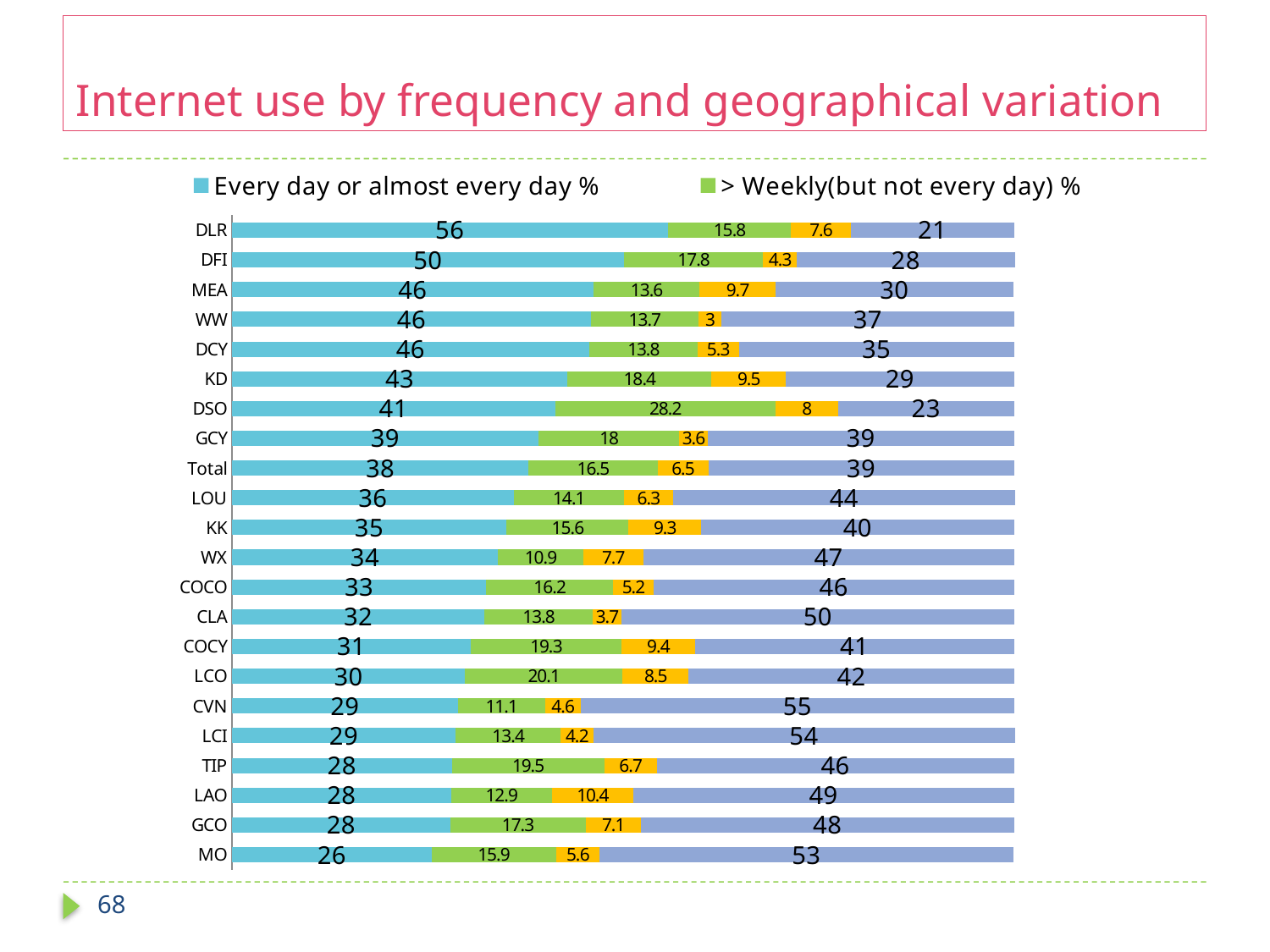
What is the '> Weekly(but not every day) %' value for DSO? 28.2 What is the difference between the 'Every day or almost every day %' values for DLR and MO? 30 Which category has the highest 'Every day or almost every day %' value? DLR Which category has the lowest 'Every day or almost every day %' value? MO What is the title of the slide? Internet use by frequency and geographical variation What is the 'Every day or almost every day %' value for MO? 26 How many categories (rows) are shown in the chart? 22 Which has the larger 'Every day or almost every day %' value, KD or DSO? KD What kind of chart is shown on the slide? Stacked bar chart What is the 'Every day or almost every day %' value for the Total row? 38 How many series does the legend list? 2 What is the 'Every day or almost every day %' value for DLR? 56